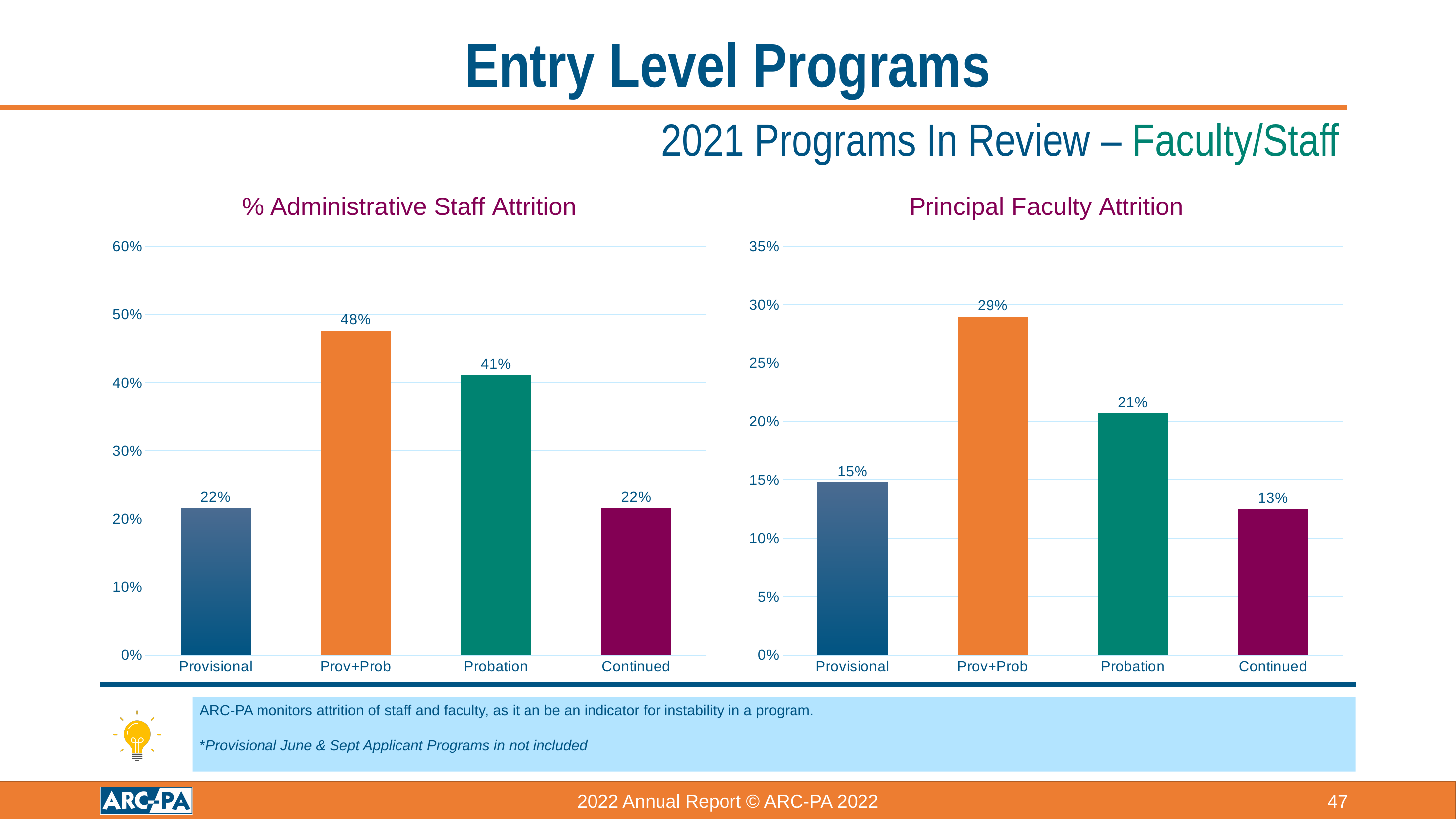
In the 'Principal Faculty Attrition' chart, which category has the lowest value? Continued What kind of chart is the '% Administrative Staff Attrition' chart? bar chart In the '% Administrative Staff Attrition' chart, which category has the highest value? Prov+Prob In the '% Administrative Staff Attrition' chart, is the value for Probation greater or less than 30%? greater In the 'Principal Faculty Attrition' chart, what is the difference between Prov+Prob and Probation? 8% In the '% Administrative Staff Attrition' chart, what is the value for Prov+Prob? 48% What is the title of the chart on the right side of the slide? Principal Faculty Attrition In the '% Administrative Staff Attrition' chart, what is the difference between Prov+Prob and Provisional? 26% How many categories are shown in the 'Principal Faculty Attrition' chart? 4 In the 'Principal Faculty Attrition' chart, which is larger, Provisional or Probation? Probation In the 'Principal Faculty Attrition' chart, what is the value for Continued? 13% In the 'Principal Faculty Attrition' chart, what is the value for Provisional? 15%